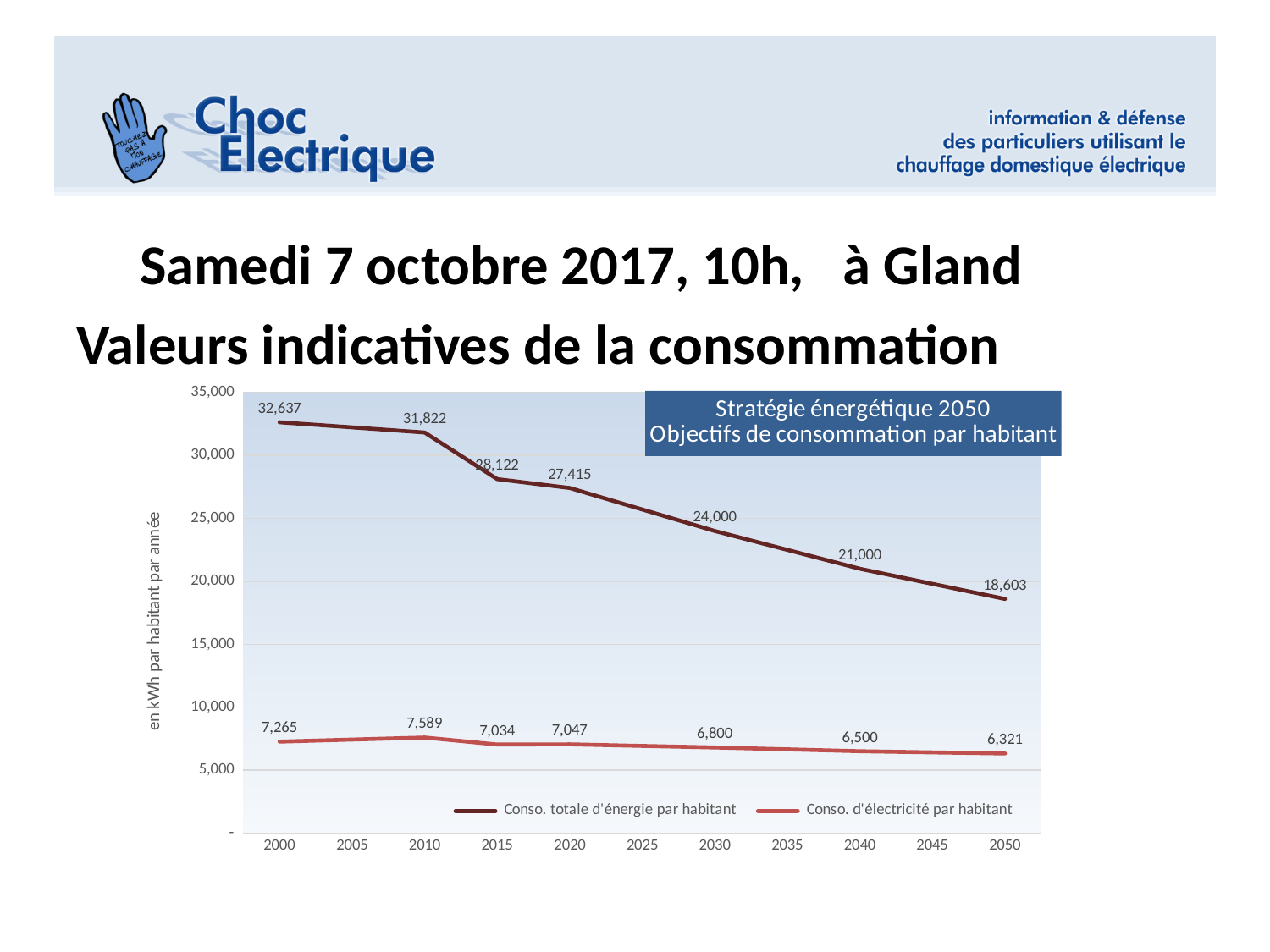
What is the value of 'Conso. totale d'énergie par habitant' in 2030? 24,000 What is the value of 'Conso. d'électricité par habitant' in 2050? 6,321 What is the difference between 'Conso. totale d'énergie par habitant' in 2000 and in 2050? 14,034 In which year is 'Conso. totale d'énergie par habitant' lowest? 2050 How many data points are labelled for the 'Conso. totale d'énergie par habitant' series? 7 In which year is 'Conso. d'électricité par habitant' highest? 2010 What is the value of 'Conso. totale d'énergie par habitant' in 2000? 32,637 Which is larger: 'Conso. d'électricité par habitant' in 2015 or in 2020? 2020 Is the value of 'Conso. totale d'énergie par habitant' in 2040 greater or less than 20,000? greater What type of chart is shown on the slide? line chart Does 'Conso. totale d'énergie par habitant' rise or fall from 2000 to 2050? fall How many series does the chart legend list? 2